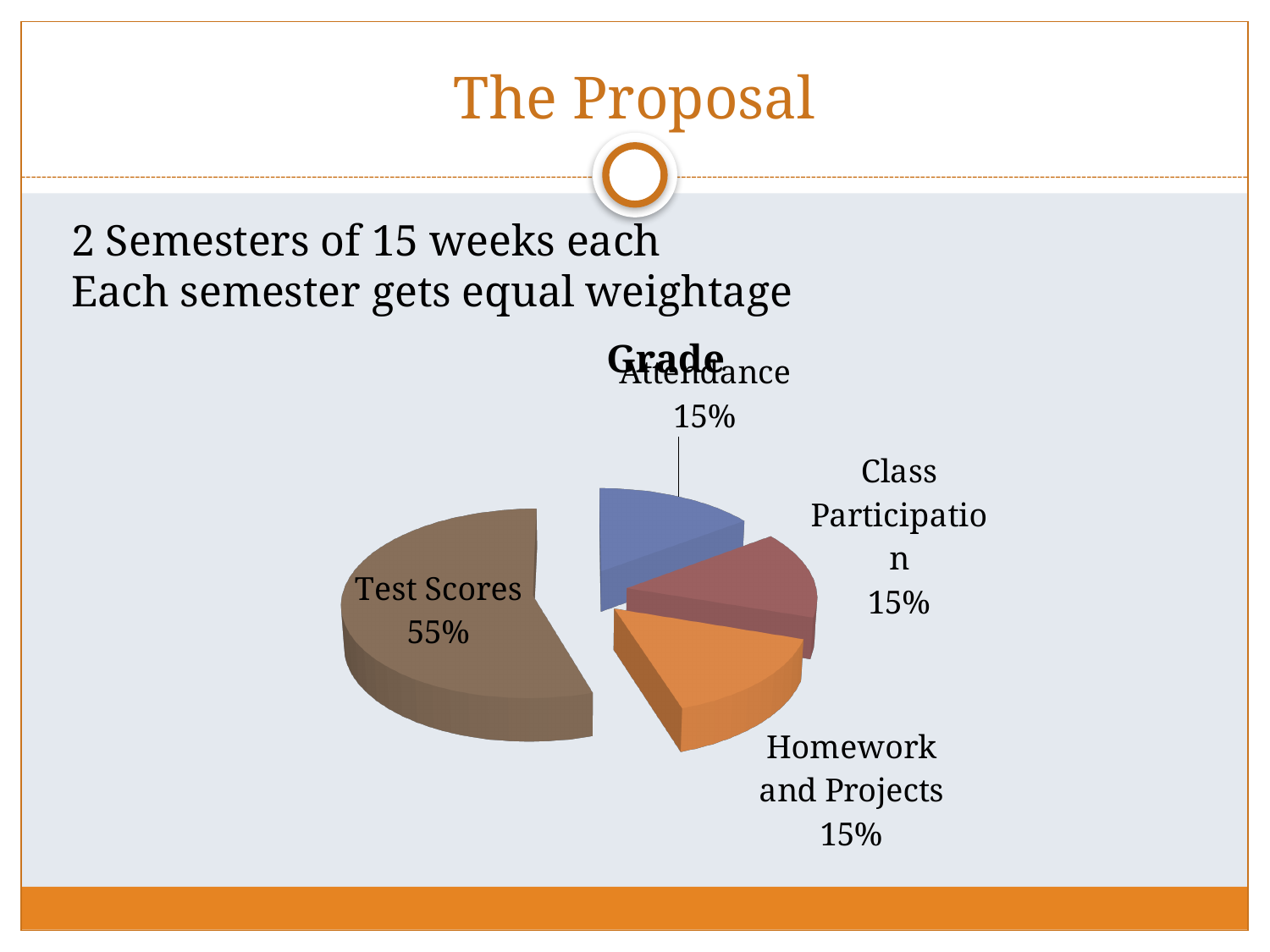
What is the title of the chart? Grade Which is larger, the share for Test Scores or the share for Homework and Projects? Test Scores What kind of chart is shown on the slide? Pie chart What percentage of the grade is Class Participation? 15% What share of the grade do Test Scores account for? 55% What is the difference between the Test Scores share and the Attendance share? 40% How many categories are shown in the pie chart? 4 What is the combined share of Attendance, Class Participation, and Homework and Projects? 45% What colour is the Test Scores slice? Brown Which category has the largest share of the grade? Test Scores What percentage of the grade is Attendance? 15% What percentage of the grade is Homework and Projects? 15%